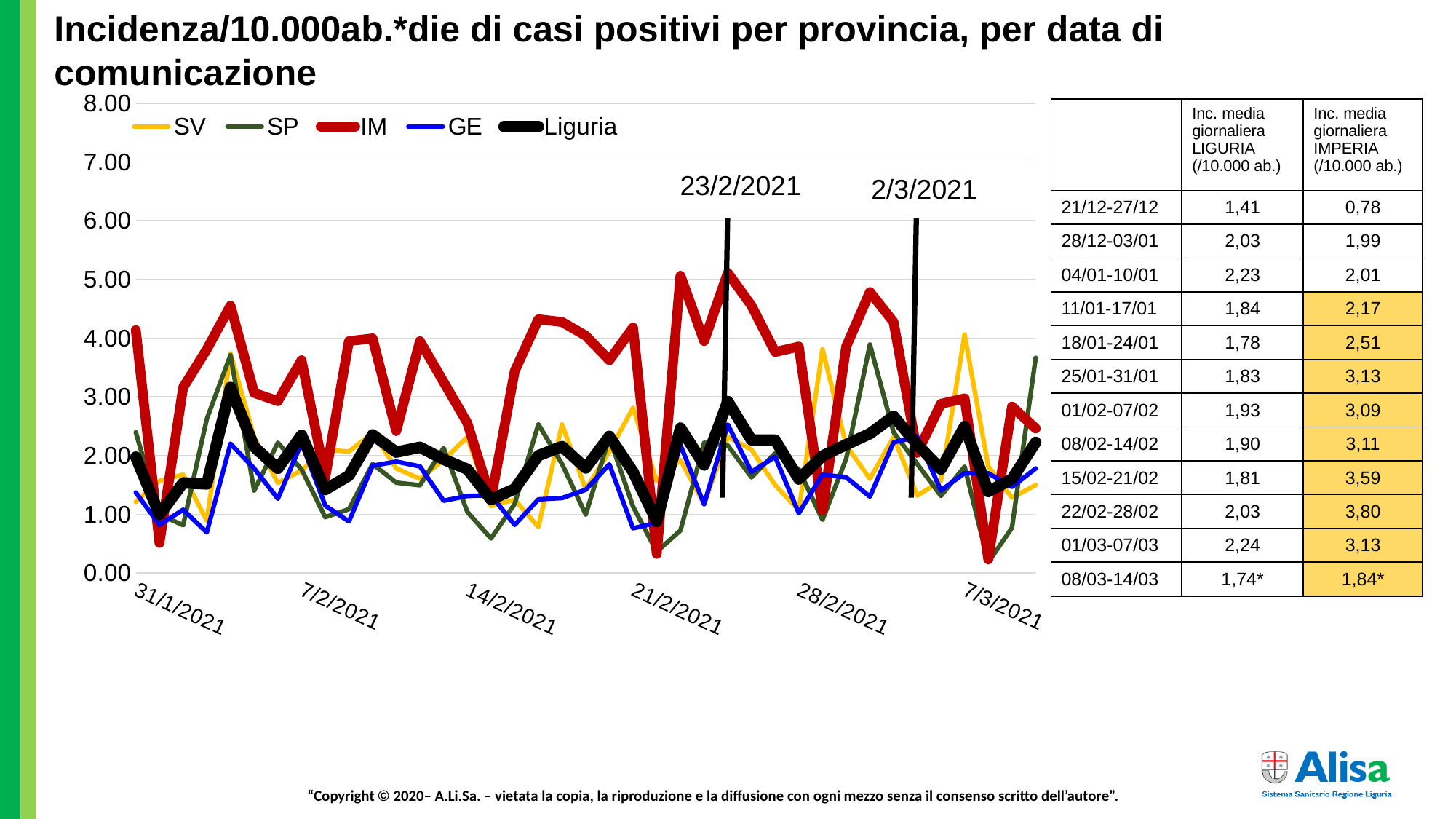
What kind of chart is shown on the slide? line chart What is the highest value shown on the y axis? 8.00 Is the value for IM at 21/2/2021 greater or less than 1.00? greater Around 23/2/2021, which series has the larger value, IM or GE? IM How many series does the chart legend list? 5 How many date labels are shown on the x axis? 6 Is the value for IM at 7/3/2021 greater or less than 1.00? greater What are the two dates marked by vertical lines on the chart? 23/2/2021 and 2/3/2021 Is the highest value of the Liguria line greater or less than 4.00? less Which series reaches the highest value anywhere on the chart? IM